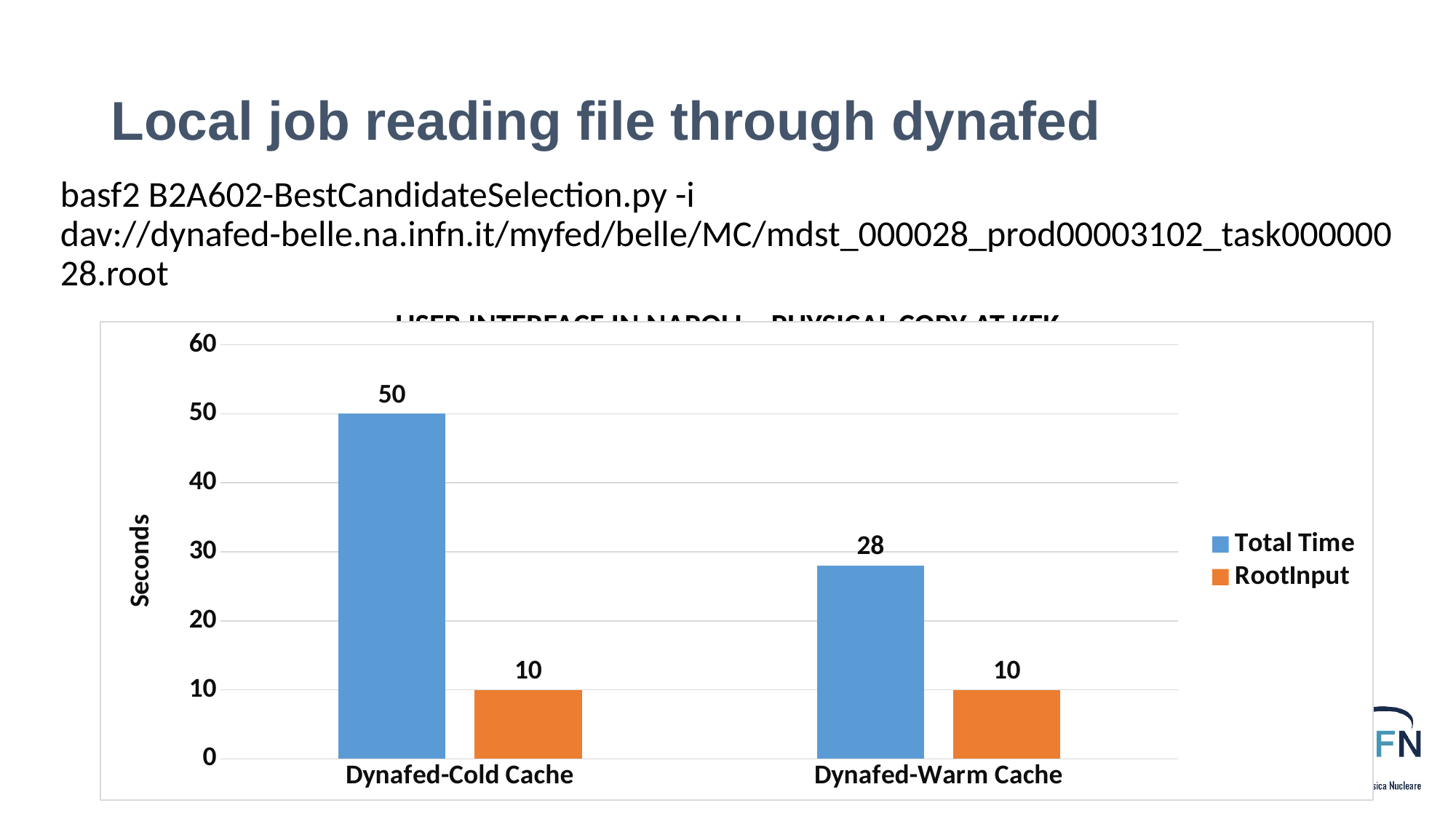
How many categories are shown on the x axis? 2 What is the RootInput value for Dynafed-Cold Cache? 10 What is the difference in Total Time between Dynafed-Cold Cache and Dynafed-Warm Cache? 22 What is the difference between Total Time and RootInput for Dynafed-Warm Cache? 18 What is the label of the y axis? Seconds What is the Total Time value for Dynafed-Warm Cache? 28 What kind of chart is shown on the slide? bar chart How many series does the legend list? 2 Which is larger: Total Time for Dynafed-Warm Cache or RootInput for Dynafed-Warm Cache? Total Time for Dynafed-Warm Cache What is the Total Time value for Dynafed-Cold Cache? 50 Which category has the highest Total Time? Dynafed-Cold Cache Is the Total Time for Dynafed-Warm Cache greater or less than 30? less